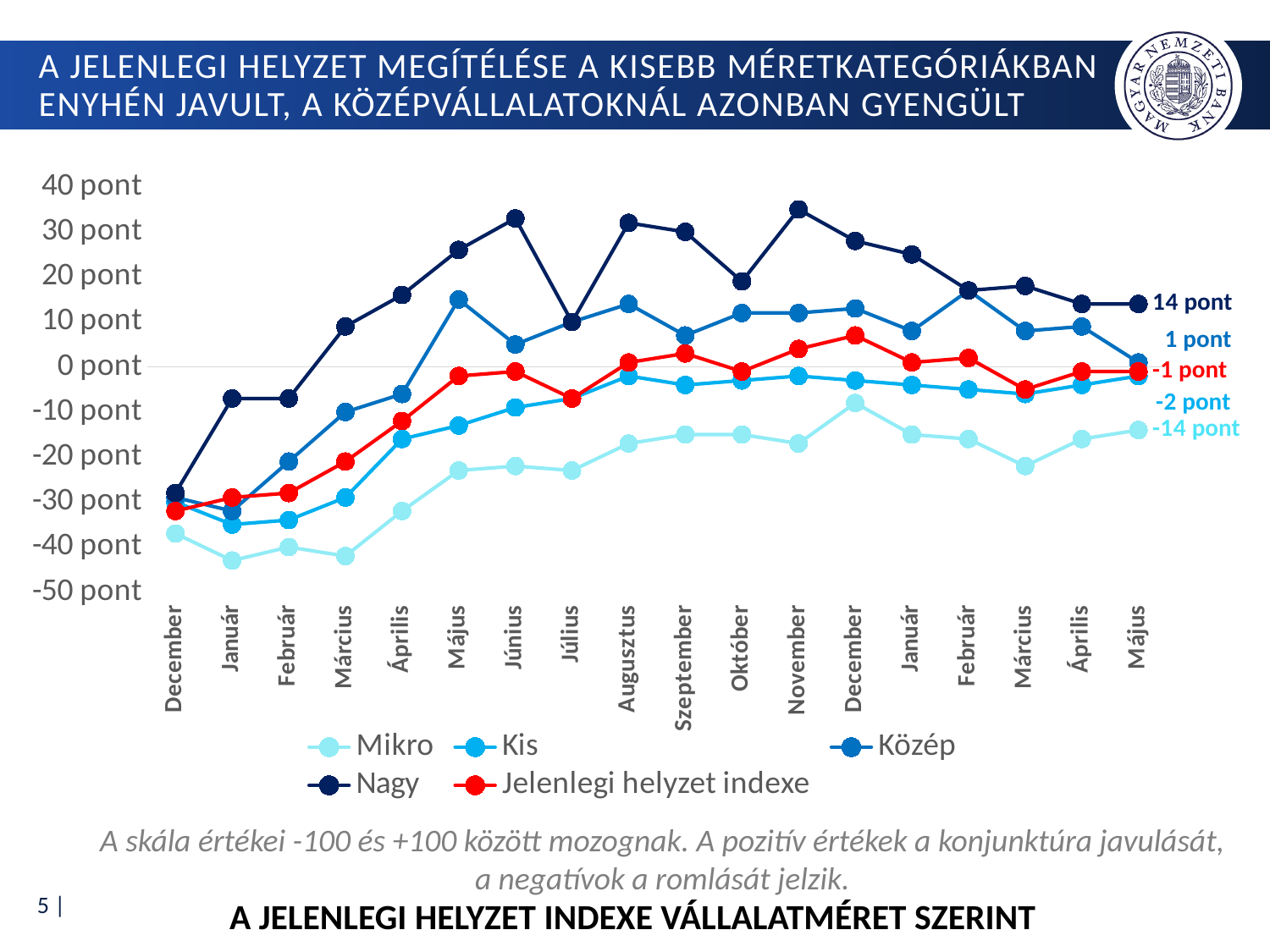
What is the value of the Jelenlegi helyzet indexe series at the final Május point? -1 pont How many months are plotted along the x axis? 18 Which series has the lowest value at the final Május point? Mikro Does the Mikro series rise or fall from the first December to the final Május? rises What is the difference between the Nagy and Közép values at the final Május point? 13 pont Which series has the highest value at the final Május point? Nagy What is the value of the Nagy series at the final Május point? 14 pont What is the value of the Mikro series at the final Május point? -14 pont What is the title of the chart? A JELENLEGI HELYZET INDEXE VÁLLALATMÉRET SZERINT What kind of chart is shown on the slide? line chart How many series does the legend list? 5